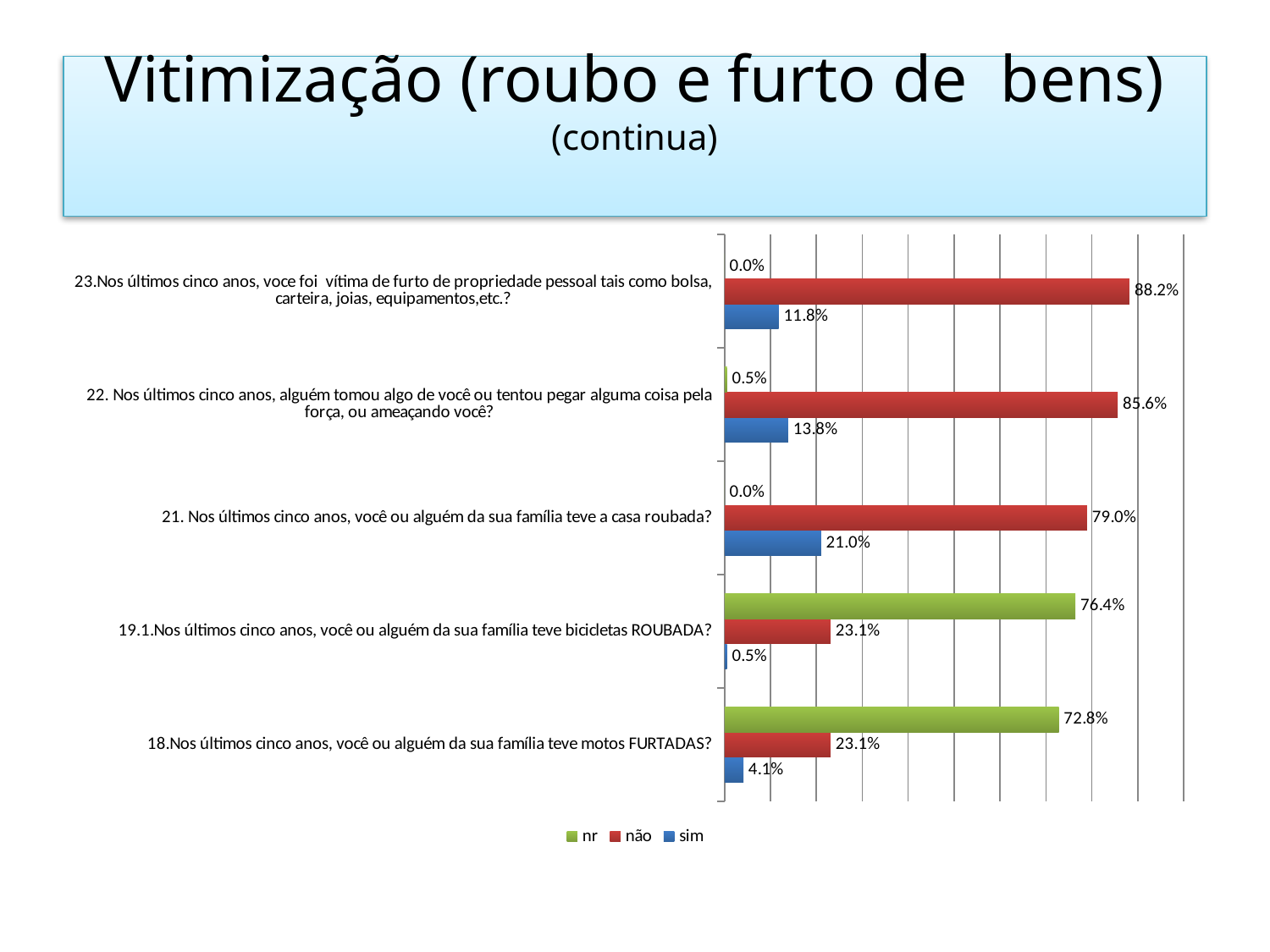
What is the 'nr' value for question 19.1 (bicicletas ROUBADA)? 76.4% What is the difference between the 'não' values for question 23 and question 22? 2.6% Which is larger: the 'nr' value for question 19.1 or the 'nr' value for question 18? question 19.1 What kind of chart is shown on the slide? bar chart Which series is shown in green in the legend? nr How many question categories are plotted on the chart? 5 Which question has the lowest 'sim' value? 19.1.Nos últimos cinco anos, você ou alguém da sua família teve bicicletas ROUBADA? What is the 'não' value for question 23 (furto de propriedade pessoal)? 88.2% What is the 'sim' value for question 18 (motos FURTADAS)? 4.1% How many series does the legend list? 3 What is the 'sim' value for question 21 (casa roubada)? 21.0% Which question has the highest 'sim' value? 21. Nos últimos cinco anos, você ou alguém da sua família teve a casa roubada?